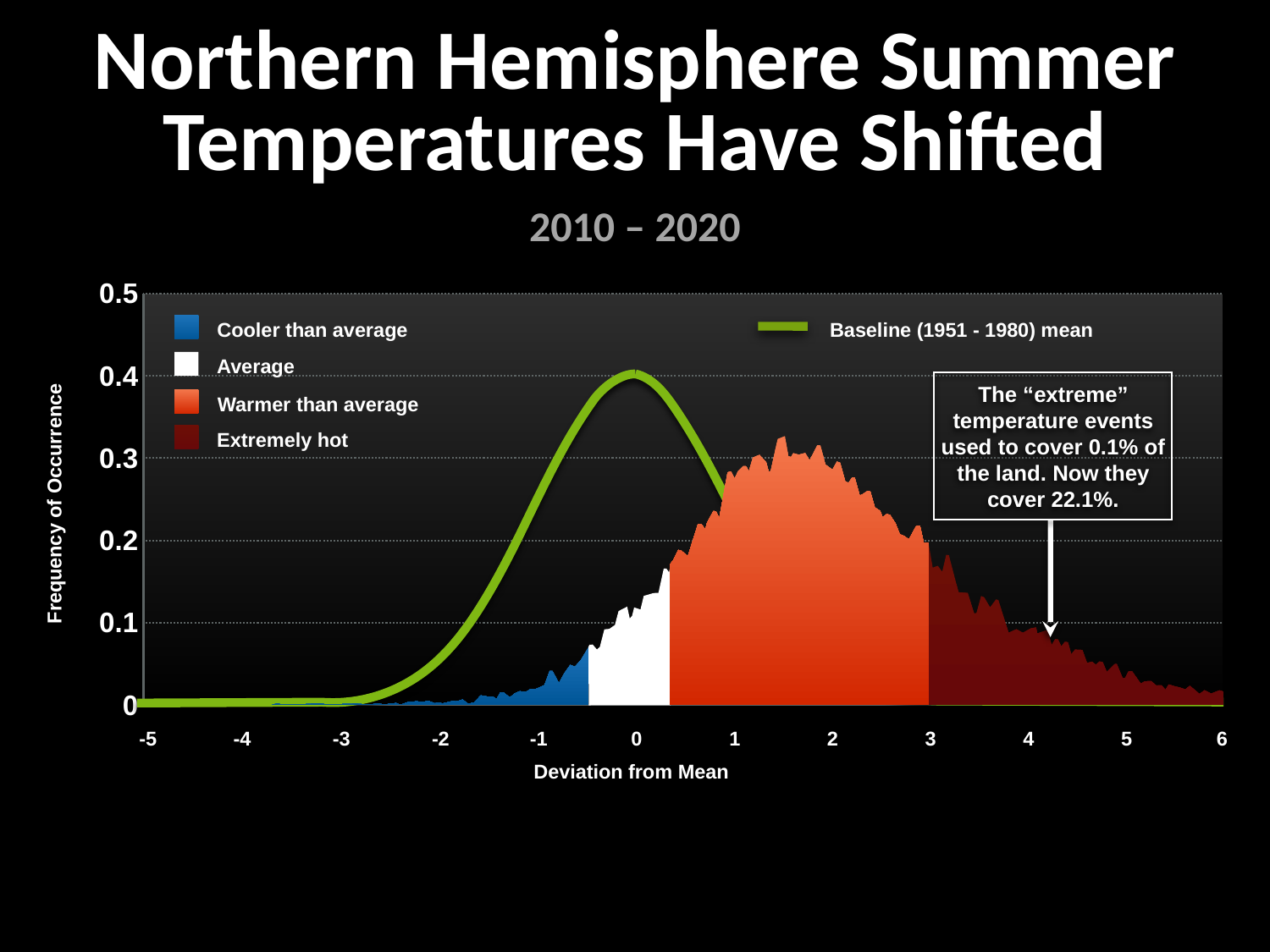
Is the peak of the 2010 – 2020 distribution greater or less than 0.4? less What does the green line on the chart represent? Baseline (1951 - 1980) mean What kind of chart is shown on the slide? Area chart At what deviation from mean does the baseline curve reach its peak? 0 According to the annotation, what share of the land did "extreme" temperature events used to cover, and what share do they cover now? 0.1% and 22.1% Which peaks higher: the baseline (1951 - 1980) curve or the 2010 – 2020 distribution? Baseline (1951 - 1980) curve What is the label of the y axis? Frequency of Occurrence How many entries does the chart's legend list in total? 5 Is the peak of the baseline (1951 - 1980) curve greater or less than 0.3? greater Between a deviation of 3 and 6, does the frequency of extremely hot events rise or fall? Fall What is the label of the x axis? Deviation from Mean Which colour represents the "Extremely hot" category? Dark red